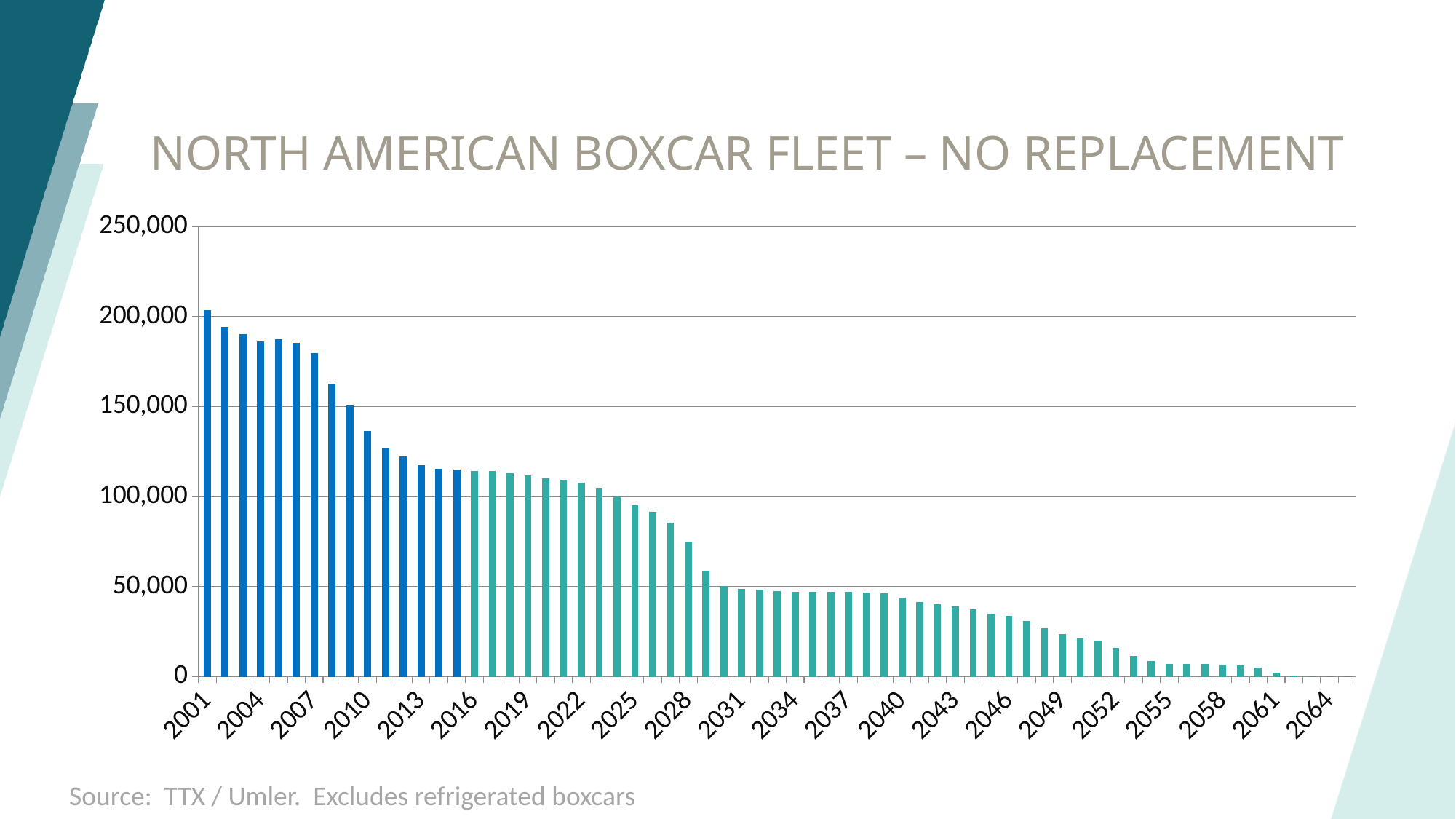
Which is larger, the value for 2019 or the value for 2028? 2019 What kind of chart is shown on the slide? Bar chart Do the values generally rise or fall from 2001 to 2064? Fall What is the title of the chart? NORTH AMERICAN BOXCAR FLEET – NO REPLACEMENT Is the value for 2007 greater or less than 150,000? greater Is the value for 2016 greater or less than 100,000? greater Is the value for 2049 greater or less than 50,000? less Which year has the highest value in the chart? 2001 Which is larger, the value for 2004 or the value for 2010? 2004 What is the source cited for the chart data? TTX / Umler